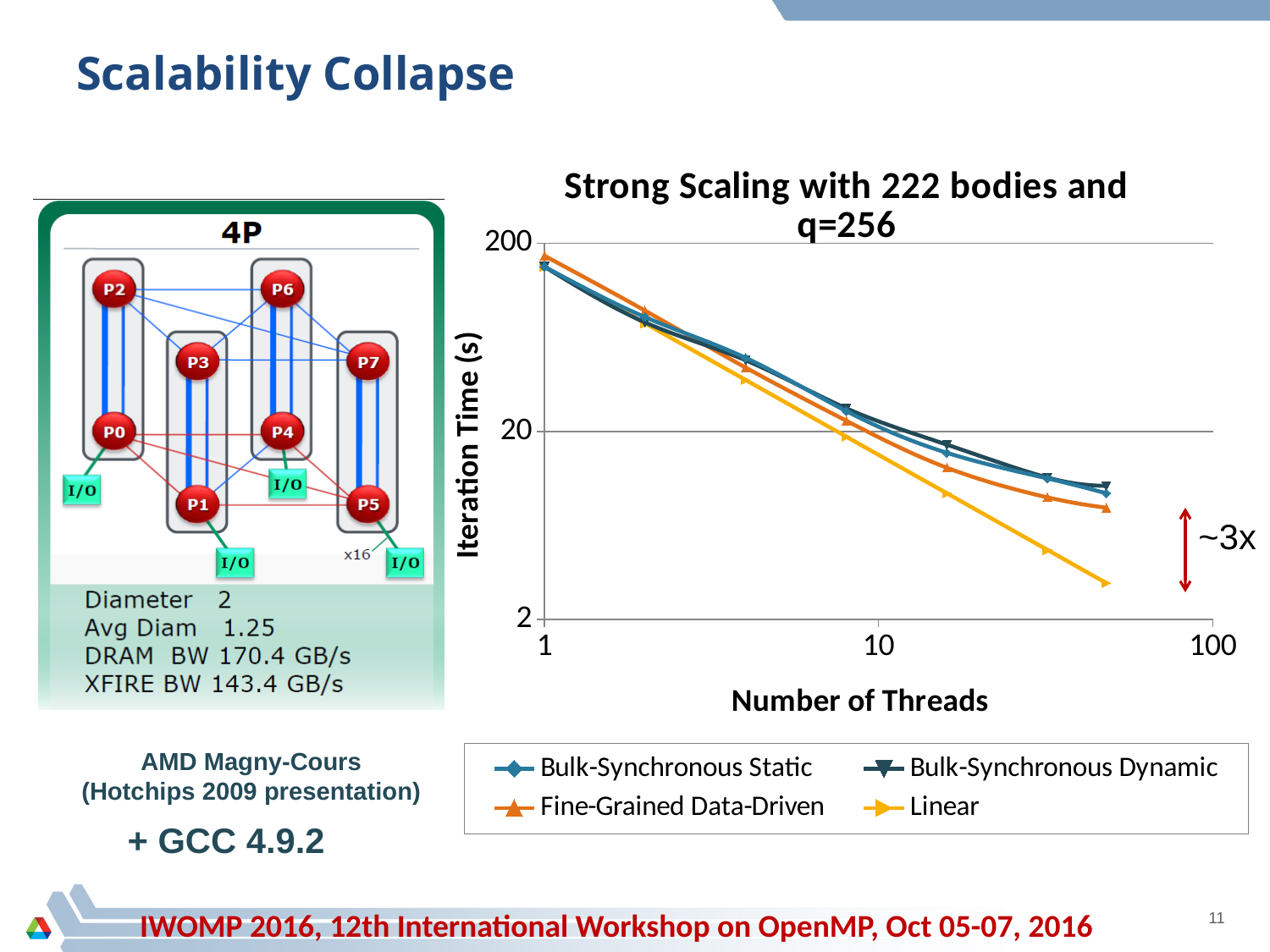
At the largest number of threads plotted, is the iteration time for the Linear series greater or less than 20? less What kind of chart is shown on the slide? line chart How many series does the chart legend list? 4 What is the label of the y axis of the chart? Iteration Time (s) What is the title of the chart? Strong Scaling with 222 bodies and q=256 At the largest number of threads plotted, which has the lower iteration time: Fine-Grained Data-Driven or Bulk-Synchronous Dynamic? Fine-Grained Data-Driven Do the iteration times rise or fall as the number of threads increases? fall At the largest number of threads plotted, which has the higher iteration time: Bulk-Synchronous Static or Linear? Bulk-Synchronous Static At 1 thread, is the iteration time for Bulk-Synchronous Dynamic greater or less than 20? greater At the largest number of threads plotted, is the iteration time for the Linear series greater or less than 2? greater Which series has the lowest iteration time at the largest number of threads plotted? Linear